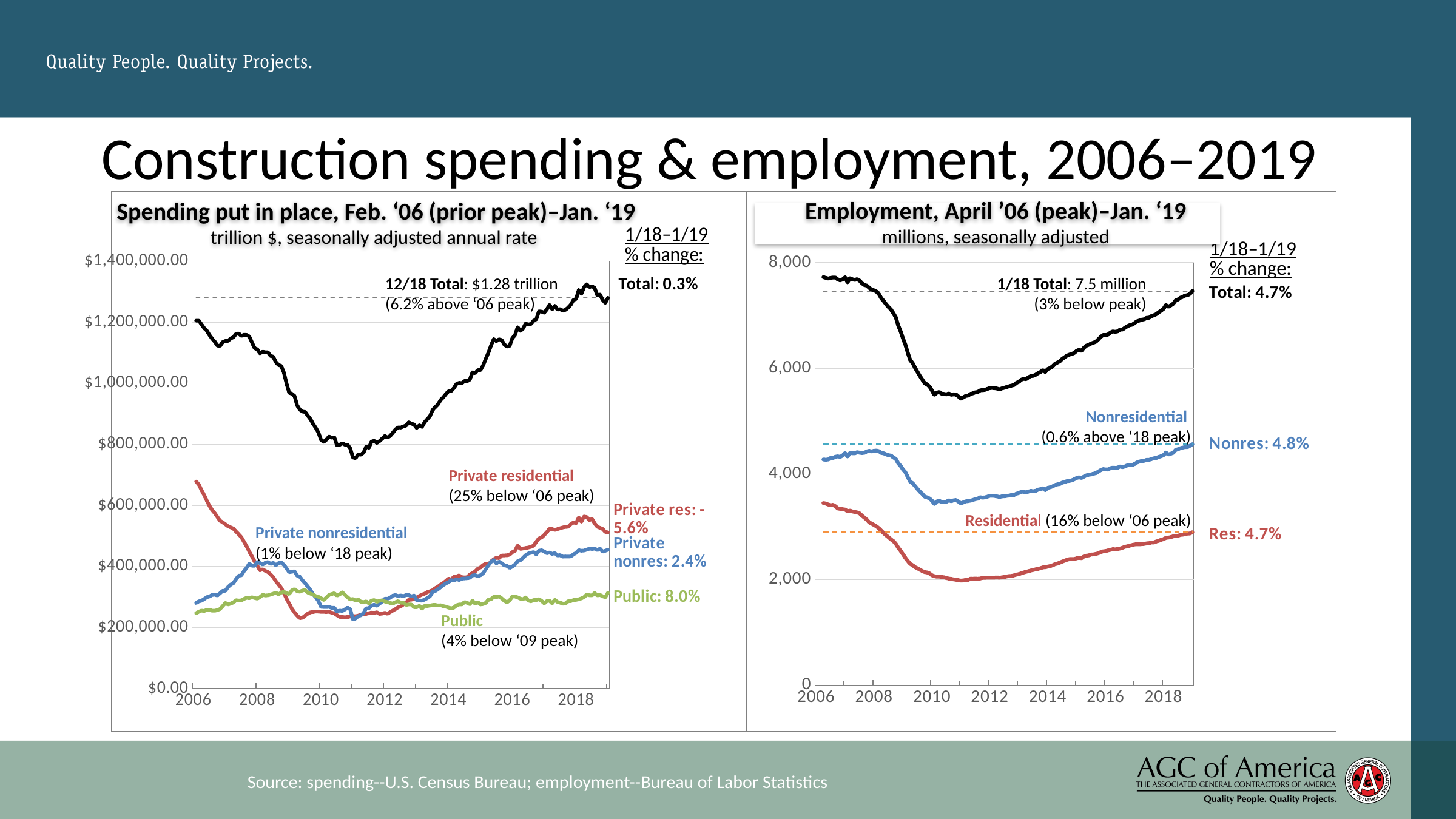
On the employment chart, what was the 1/18 Total employment? 7.5 million On the spending chart, what was the 12/18 Total spending? $1.28 trillion On the spending chart, which 1/18–1/19 % change is larger: Private nonres or Public? Public On the employment chart, what is the 1/18–1/19 % change for Nonres employment? 4.8% On the spending chart, which category has the highest 1/18–1/19 % change? Public On the spending chart, is the Public spending value in 2018 greater or less than $400,000.00? less On the spending chart, what is the 1/18–1/19 % change for Private residential spending? -5.6% On the employment chart, is the Residential employment value in 2018 greater or less than 4,000? less On the employment chart, does Total employment rise or fall from 2011 to 2018? rise What kind of chart is the 'Spending put in place' chart on the left? line chart On the spending chart, what is the 1/18–1/19 % change for Public spending? 8.0%